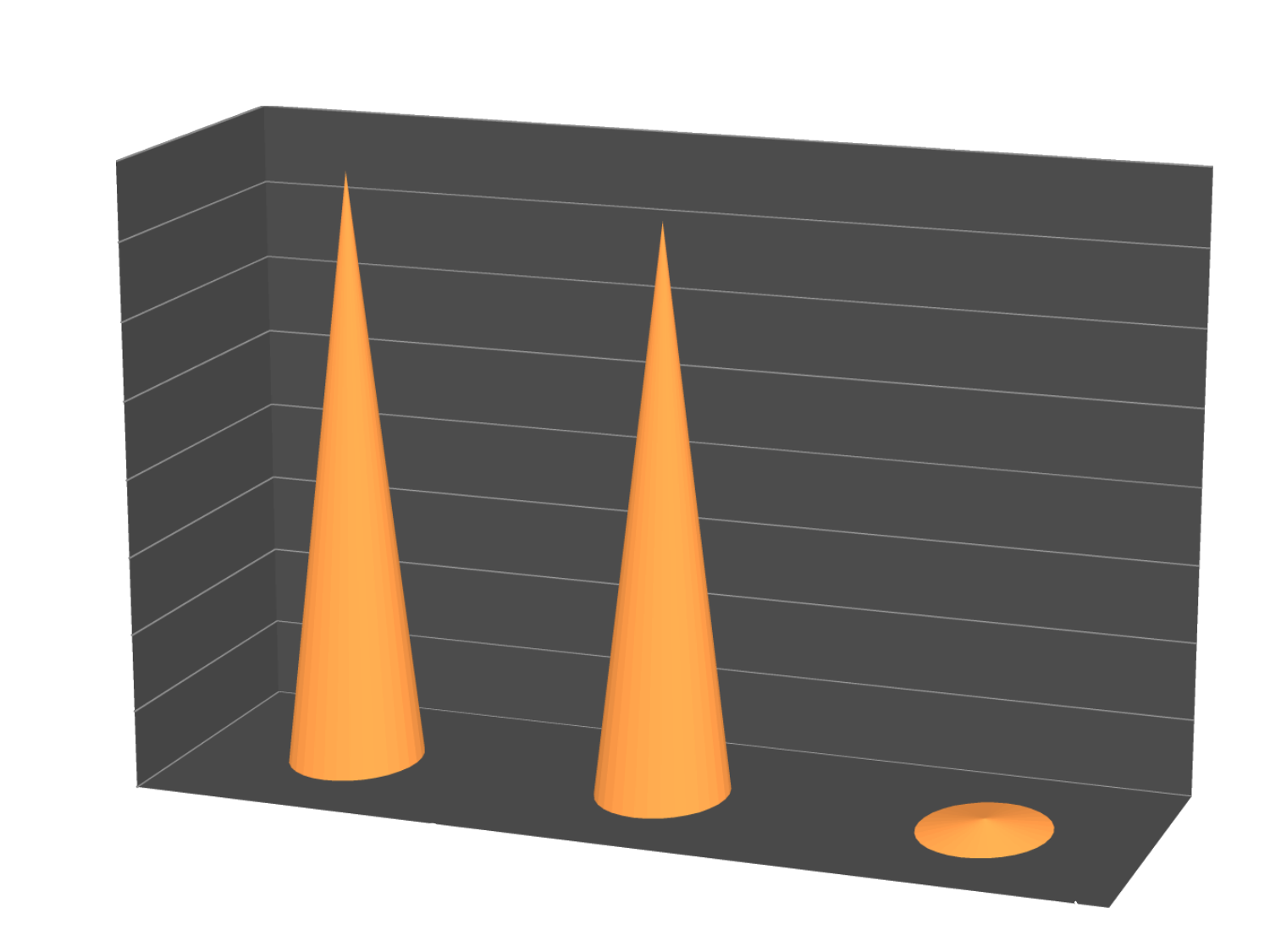
Which bar is the shortest on the chart: the first, second or third from the left? the third What colour are the bars on the chart? orange Which is larger, the first bar from the left or the third bar from the left? the first bar Which bar is the tallest on the chart: the first, second or third from the left? the first Do the bar values rise or fall from left to right across the chart? fall How many bars (cones) are plotted on the chart? 3 What shape are the bars drawn as on the chart? cones What kind of chart is shown on the slide? bar chart